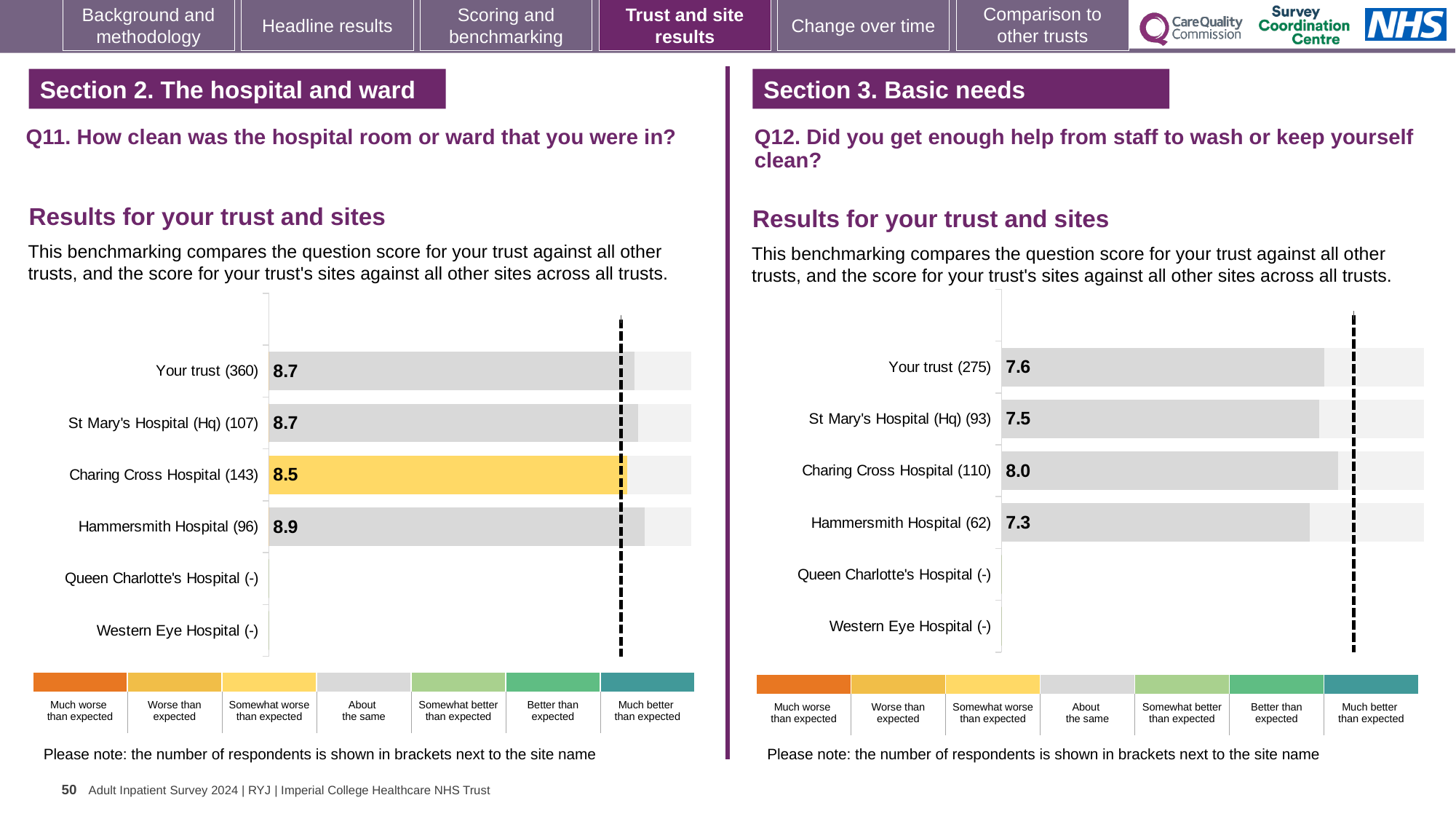
In the Q11 chart on the left, what is the score for Charing Cross Hospital? 8.5 What type of chart is used for the Q11 results on the left? Bar chart In the Q12 chart on the right, what is the score for Your trust? 7.6 In the Q11 chart on the left, what is the score for Hammersmith Hospital? 8.9 In the Q11 chart on the left, which site with a plotted score has the lowest score? Charing Cross Hospital In the Q12 chart on the right, which is larger: the score for St Mary's Hospital (Hq) or the score for Charing Cross Hospital? Charing Cross Hospital In the Q11 chart on the left, how many respondents are shown for Your trust? 360 In the Q12 chart on the right, what is the difference between the scores for Charing Cross Hospital and Hammersmith Hospital? 0.7 In the Q11 chart on the left, what is the difference between the scores for Hammersmith Hospital and Charing Cross Hospital? 0.4 In the Q11 chart on the left, which site has the highest score? Hammersmith Hospital In the Q12 chart on the right, which site has the highest score? Charing Cross Hospital In the Q12 chart on the right, which site with a plotted score has the lowest score? Hammersmith Hospital